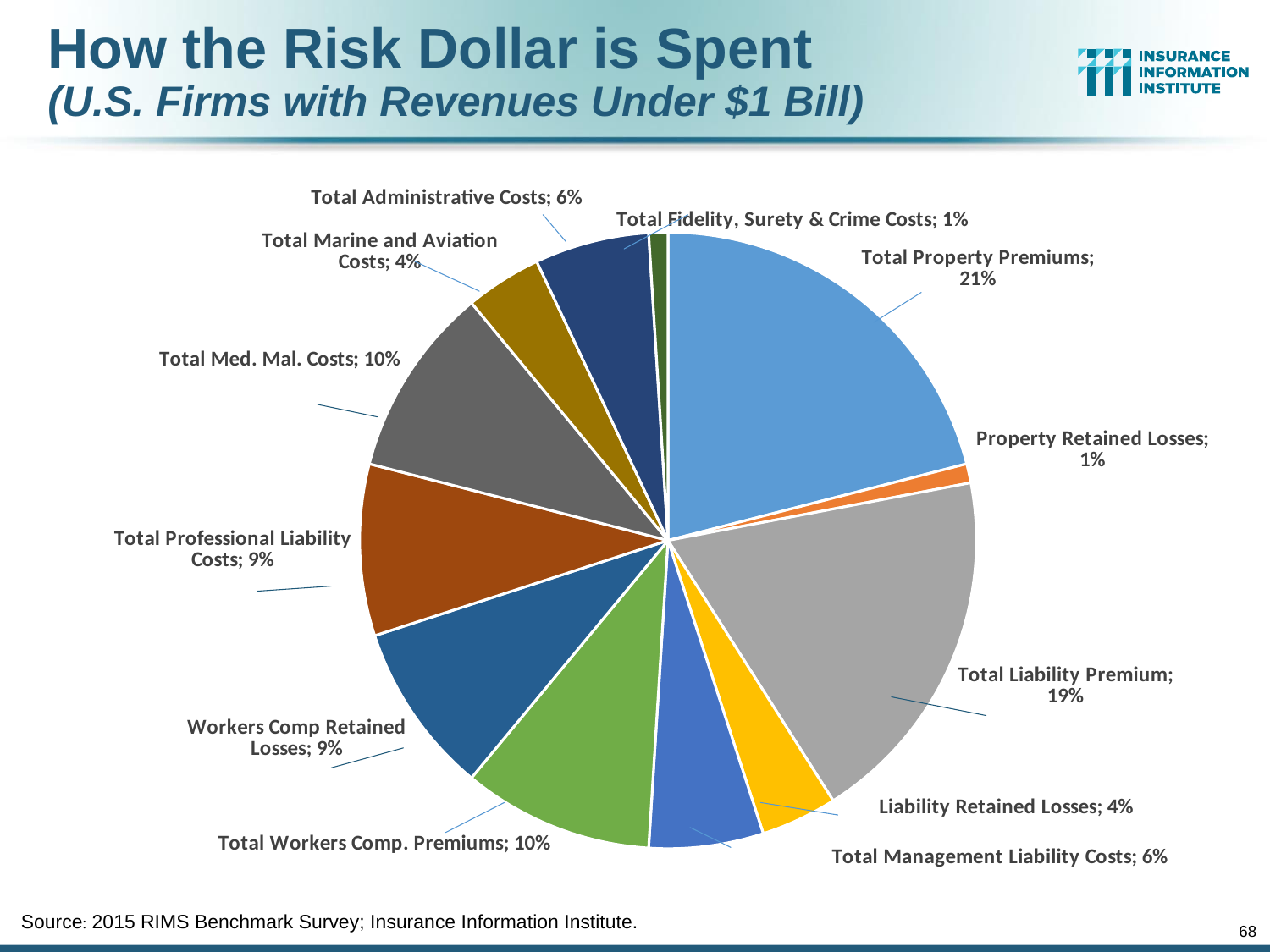
What share of the risk dollar goes to Total Property Premiums? 21% What is the difference in percentage points between Total Workers Comp. Premiums and Workers Comp Retained Losses? 1 percentage point What is the difference in percentage points between Total Property Premiums and Total Liability Premium? 2 percentage points Which category has the largest share of the pie? Total Property Premiums How many slices does the pie chart have? 12 What percentage is shown for Total Marine and Aviation Costs? 4% What share of the risk dollar goes to Total Liability Premium? 19% What kind of chart is shown on the slide? Pie chart Which is larger, Total Property Premiums or Total Liability Premium? Total Property Premiums What percentage is shown for Total Fidelity, Surety & Crime Costs? 1% What is the title of the chart on the slide? How the Risk Dollar is Spent (U.S. Firms with Revenues Under $1 Bill) What percentage is shown for Total Med. Mal. Costs? 10%